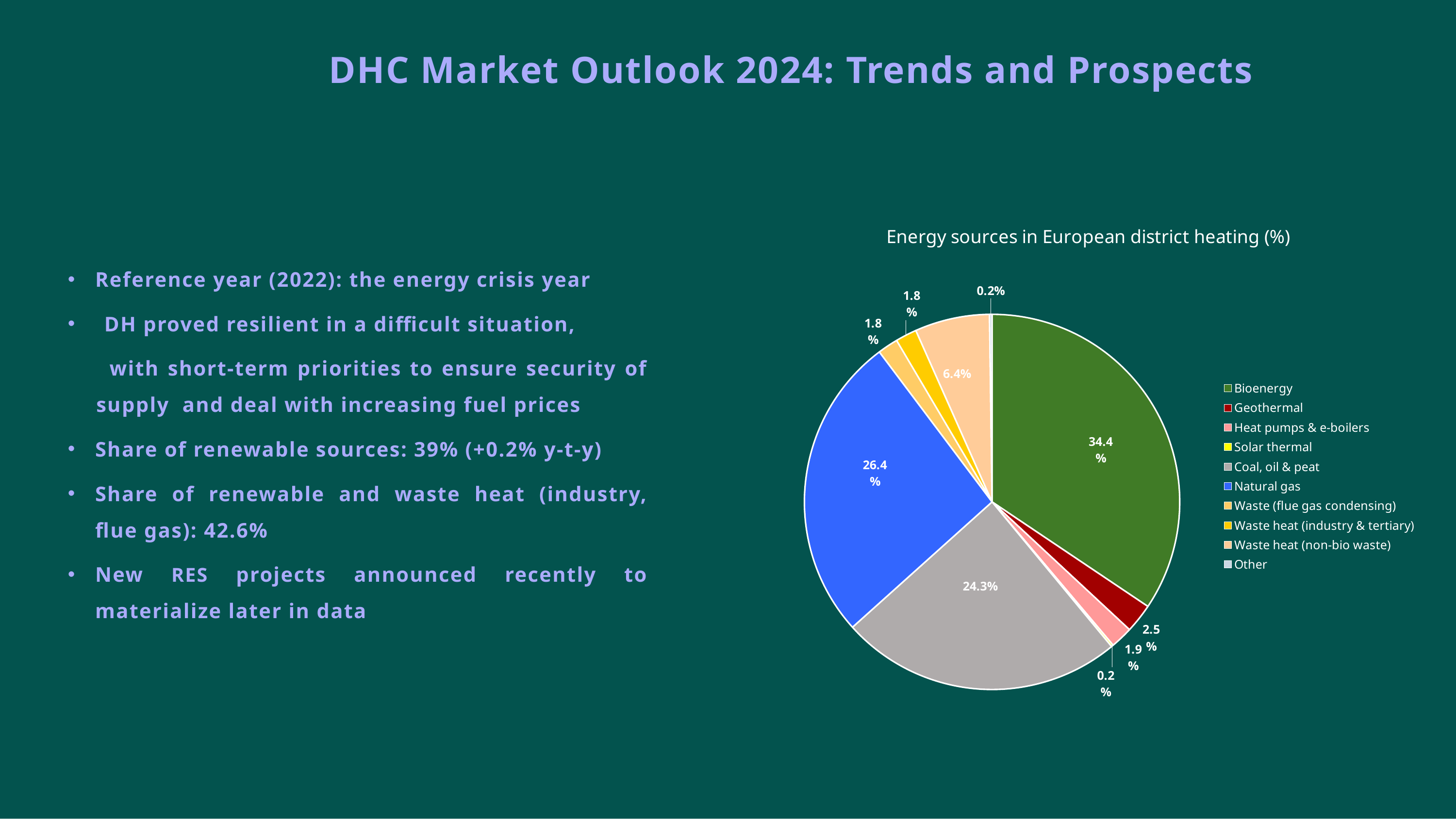
What type of chart is shown on the slide? Pie chart What share does Coal, oil & peat have in the pie chart? 24.3% What is the difference in percentage points between the Bioenergy share and the Natural gas share? 8.0 What share does Bioenergy have in the pie chart? 34.4% What is the title of the chart? Energy sources in European district heating (%) How many energy source categories are listed in the chart legend? 10 What share does Waste heat (non-bio waste) have in the pie chart? 6.4% What share does Geothermal have in the pie chart? 2.5% What share does Natural gas have in the pie chart? 26.4% Which energy source has the largest share in the pie chart? Bioenergy Which has the larger share: Natural gas or Coal, oil & peat? Natural gas What colour represents Natural gas in the pie chart? Blue